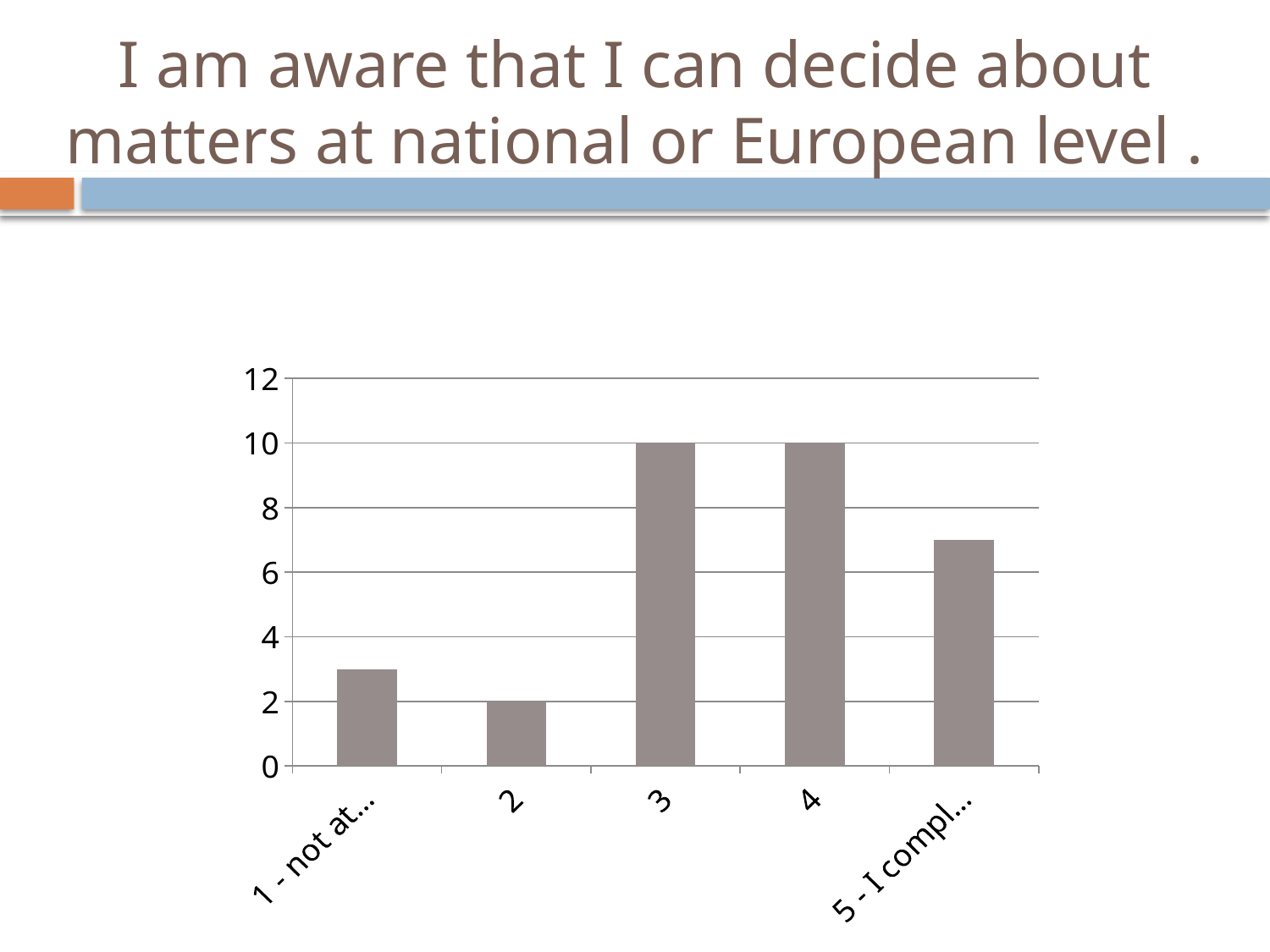
Which is larger, the value for category 4 or the value for the category labelled '5 - I compl...'? 4 What is the value for category 3? 10 What is the value for category 4? 10 Which category has the lowest value? 2 What type of chart is shown on the slide? bar chart Is the value for the category labelled '5 - I compl...' greater or less than 6? greater Is the value for the category labelled '1 - not at...' greater or less than 4? less What is the value for category 2? 2 What is the difference between the values for category 3 and category 2? 8 What is the highest value shown on the vertical axis of the chart? 12 Which is larger, the value for category 2 or the value for category 3? 3 How many categories are shown on the x axis of the chart? 5